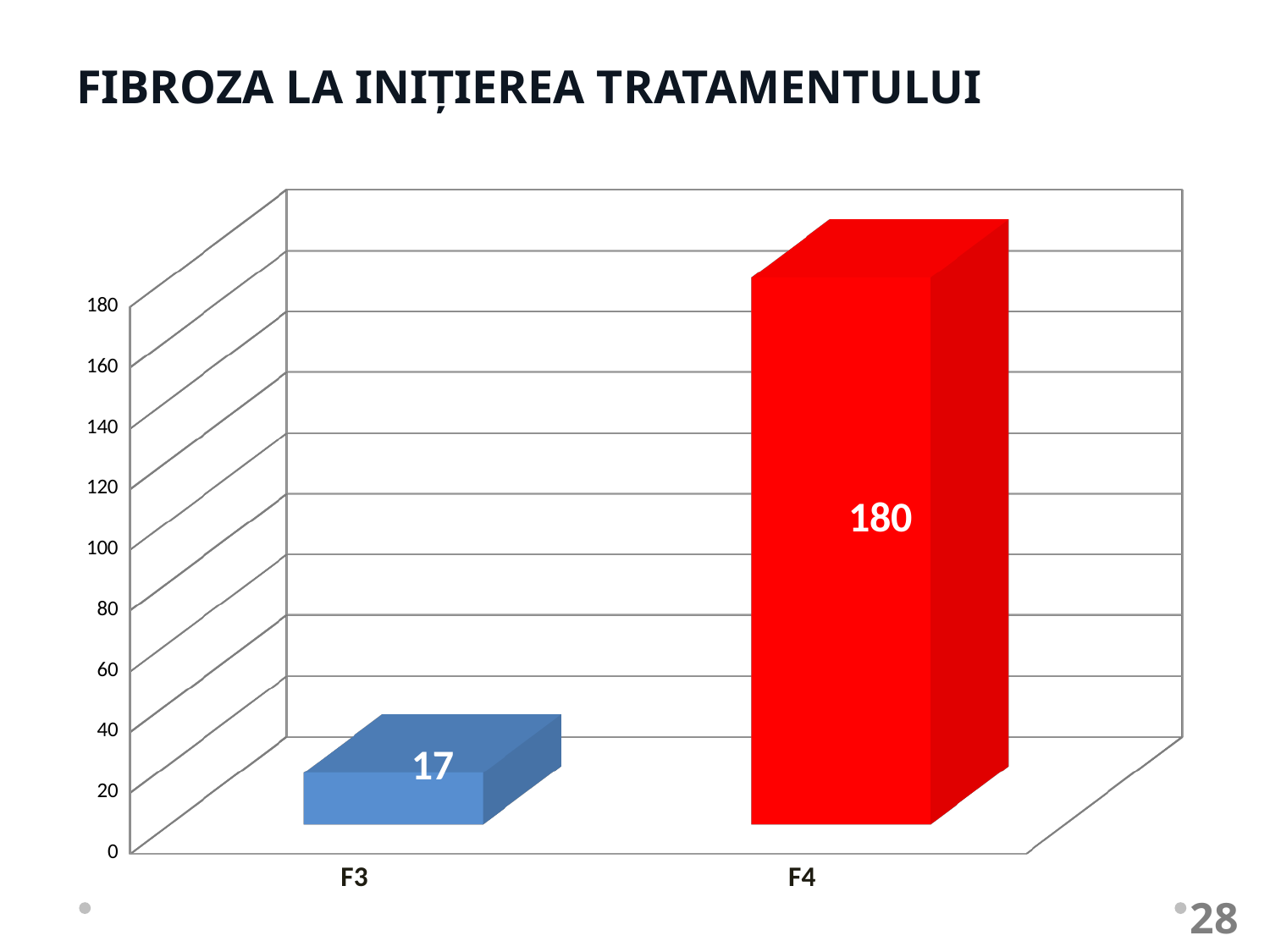
What is the title of the slide? FIBROZA LA INIȚIEREA TRATAMENTULUI Which category has the lowest value? F3 How many categories are shown on the chart? 2 What is the value for F3? 17 Which is larger, the value for F3 or the value for F4? F4 What kind of chart is shown on the slide? bar chart Which category has the highest value? F4 Is the value for F4 greater or less than 100? greater What is the difference between the values for F4 and F3? 163 What is the value for F4? 180 What colour is the bar for F4? red Is the value for F3 greater or less than 40? less